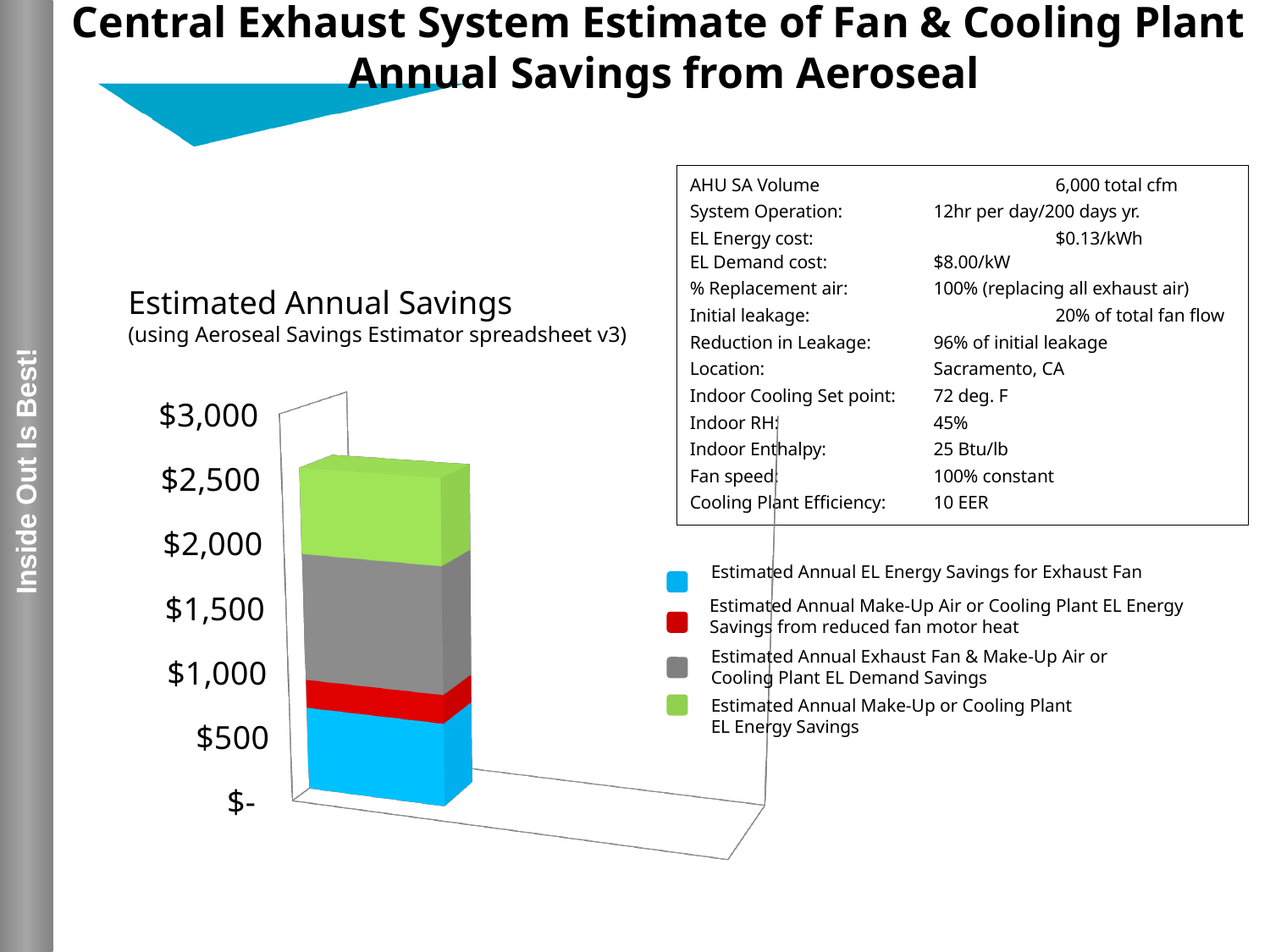
Which segment is larger: the blue (Exhaust Fan EL Energy Savings) segment or the red (reduced fan motor heat) segment? Blue (Exhaust Fan EL Energy Savings) How many series does the chart's legend list? 4 Which series forms the smallest segment of the stacked bar? Estimated Annual Make-Up Air or Cooling Plant EL Energy Savings from reduced fan motor heat What is the title of the chart? Estimated Annual Savings Is the total height of the stacked bar greater or less than $3,000? less How many bars are plotted in the chart? 1 Which colour represents Estimated Annual EL Energy Savings for Exhaust Fan in the chart? Blue Is the value of the red segment (savings from reduced fan motor heat) greater or less than $500? less Is the total height of the stacked bar greater or less than $2,000? greater Which segment is larger: the gray (EL Demand Savings) segment or the green (Make-Up or Cooling Plant EL Energy Savings) segment? Gray (EL Demand Savings) Which series forms the largest segment of the stacked bar? Estimated Annual Exhaust Fan & Make-Up Air or Cooling Plant EL Demand Savings What kind of chart is shown on the slide? Stacked bar chart